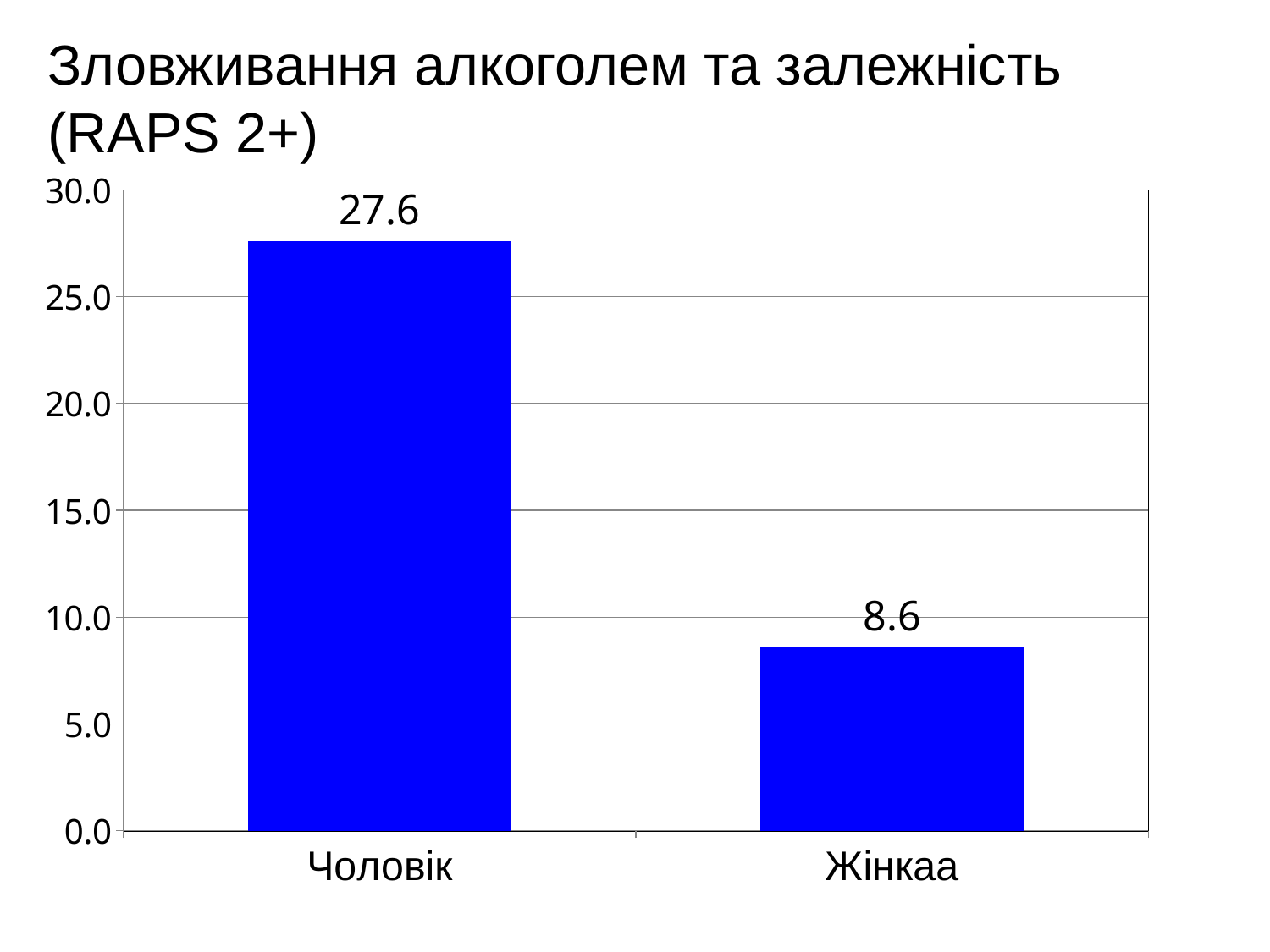
How many categories are shown on the chart? 2 Is the value for Жінкаа greater or less than 10.0? less What is the title of the slide? Зловживання алкоголем та залежність (RAPS 2+) What is the value for Жінкаа? 8.6 What kind of chart is shown on the slide? bar chart Which is larger, the value for Чоловік or the value for Жінкаа? Чоловік Which category has the lowest value? Жінкаа Which category has the highest value? Чоловік What colour are the bars in the chart? blue What is the difference between the values for Чоловік and Жінкаа? 19.0 What is the value for Чоловік? 27.6 Is the value for Чоловік greater or less than 25.0? greater